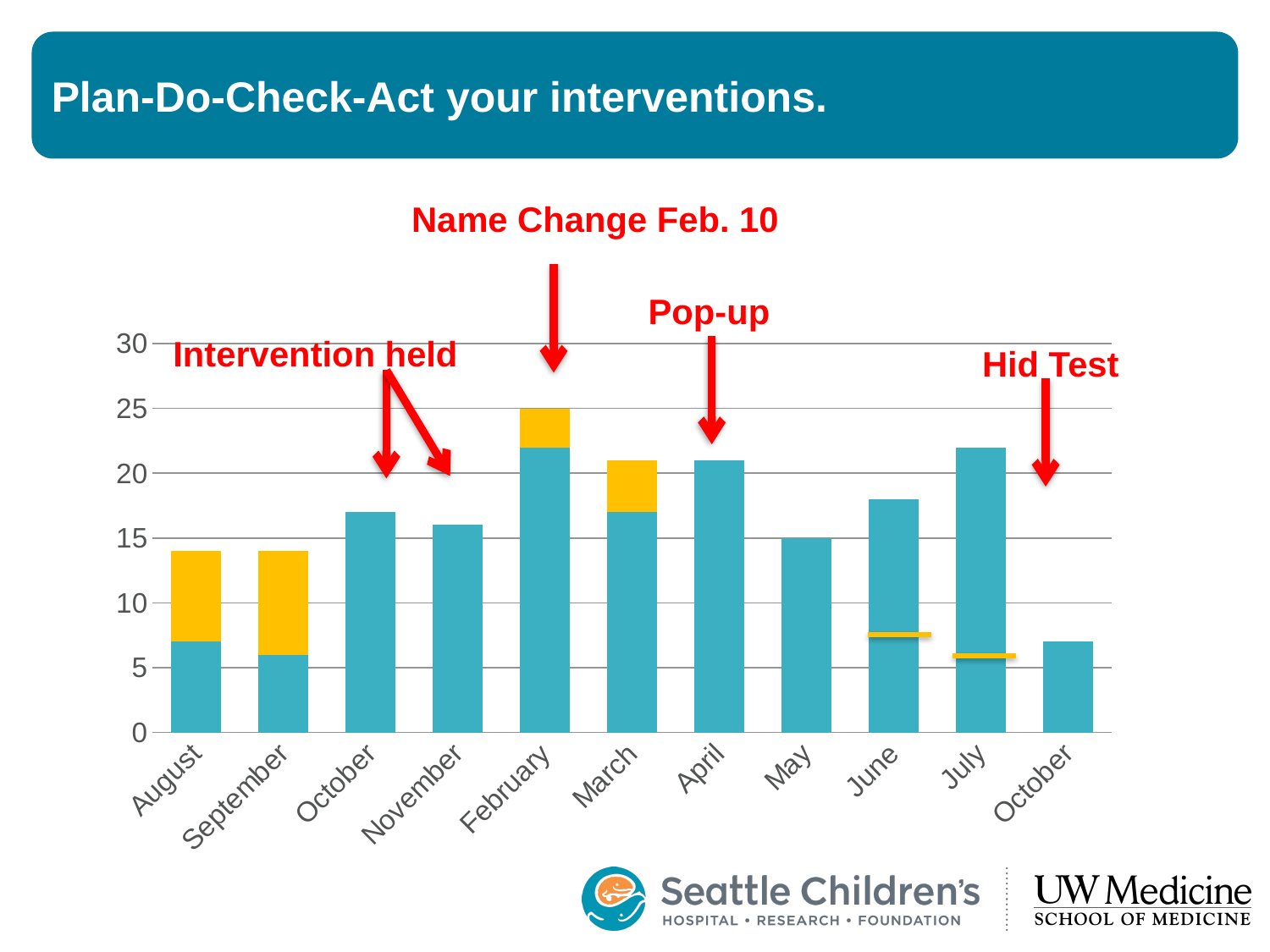
Is the value for April greater or less than 20? greater Is the value for the first October bar greater or less than 15? greater Which month has the shortest bar in the chart? October (the last bar) Is the value for July greater or less than 20? greater What kind of chart is shown on the slide? bar chart Which month has the tallest bar in the chart? February Which month does the annotation 'Name Change Feb. 10' point to? February Which annotation points to the April bar? Pop-up How many months (categories) are shown on the x axis of the chart? 11 Which bar is taller, July or May? July